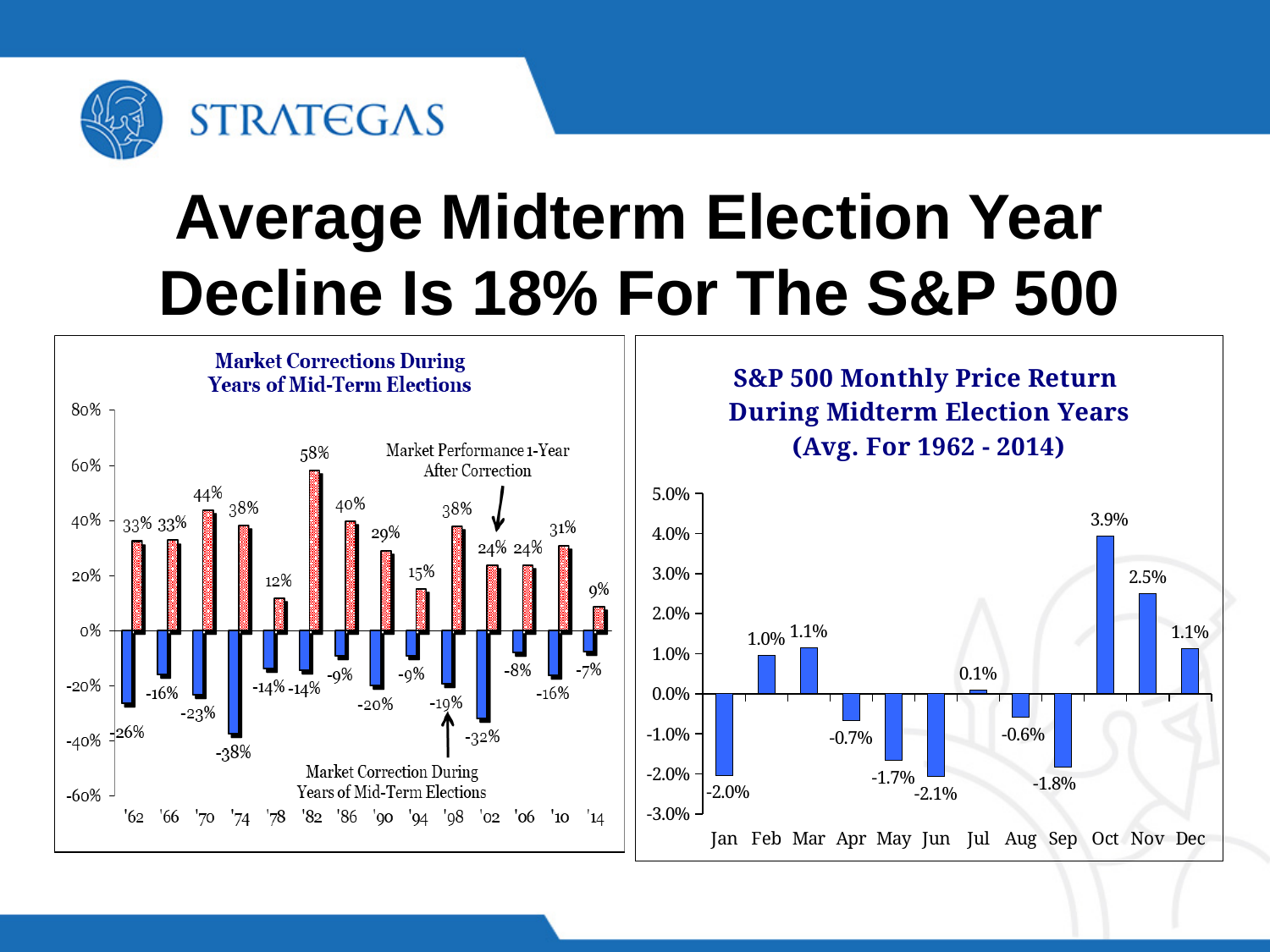
In the 'S&P 500 Monthly Price Return During Midterm Election Years' chart, which month has the lowest value? Jun In the 'S&P 500 Monthly Price Return During Midterm Election Years' chart, what is the value for Oct? 3.9% In the 'Market Corrections During Years of Mid-Term Elections' chart, which year has the smallest market correction (closest to zero)? '14 In the 'S&P 500 Monthly Price Return During Midterm Election Years' chart, what is the difference between the values for Oct and Nov? 1.4% In the 'Market Corrections During Years of Mid-Term Elections' chart, how many years are shown on the x axis? 14 In the 'S&P 500 Monthly Price Return During Midterm Election Years' chart, is the value for Jan larger or smaller than the value for Sep? smaller In the 'S&P 500 Monthly Price Return During Midterm Election Years' chart, how many months are plotted? 12 In the 'Market Corrections During Years of Mid-Term Elections' chart, what is the market correction value for '74? -38% In the 'Market Corrections During Years of Mid-Term Elections' chart, which year has the highest market performance 1-year after correction? '82 In the 'S&P 500 Monthly Price Return During Midterm Election Years' chart, which month has the highest value? Oct In the 'Market Corrections During Years of Mid-Term Elections' chart, what is the market performance 1-year after correction for '82? 58% What type of chart is the 'S&P 500 Monthly Price Return During Midterm Election Years' chart? bar chart